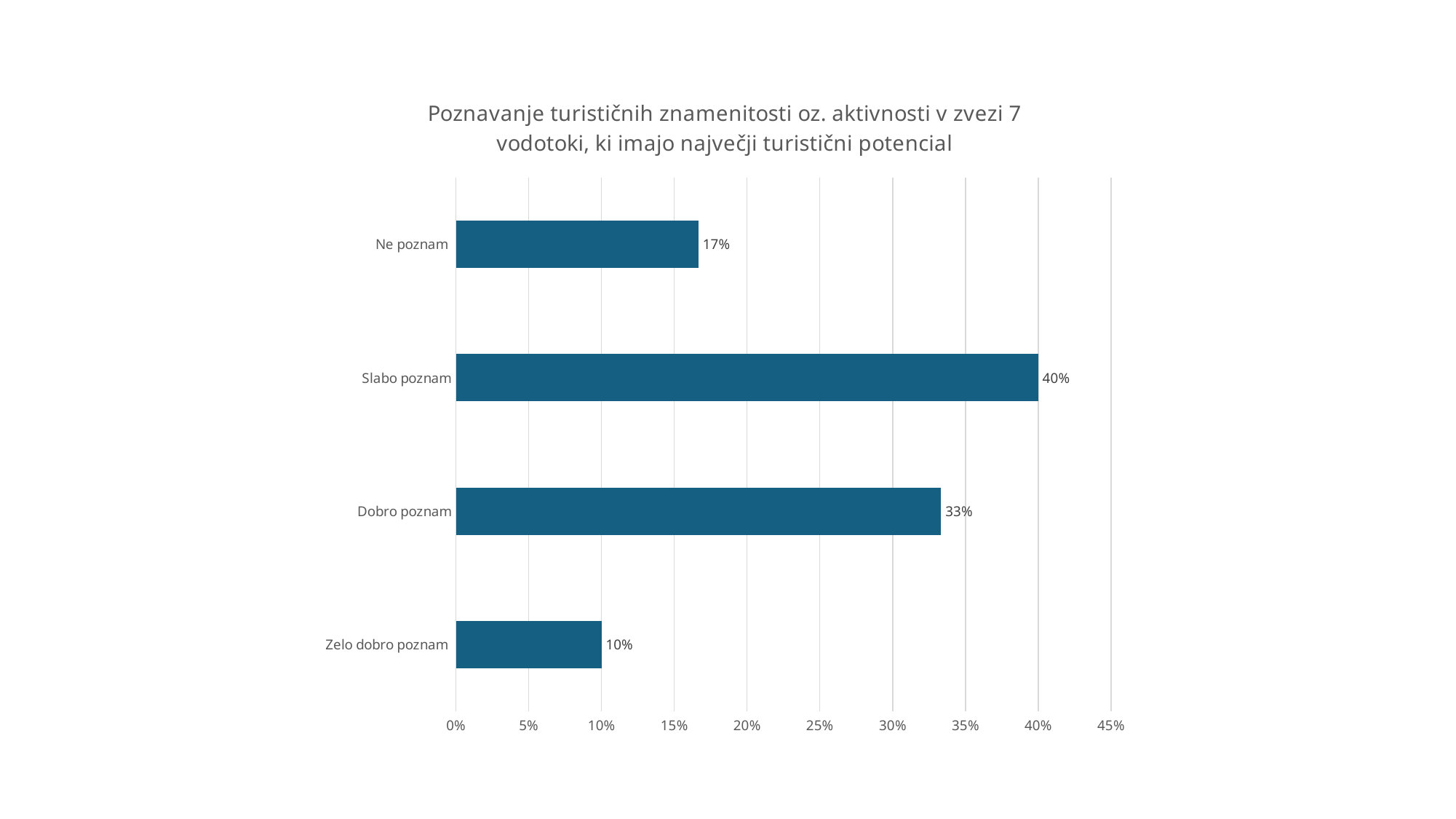
How many categories are shown in the chart? 4 What is the value for Dobro poznam? 33% Which category has the lowest value? Zelo dobro poznam What is the difference between the values for Slabo poznam and Dobro poznam? 7% What is the highest value shown on the horizontal axis? 45% Is the value for Dobro poznam greater or less than 30%? greater What kind of chart is shown on the slide? bar chart What is the value for Ne poznam? 17% Which is larger, the value for Ne poznam or the value for Zelo dobro poznam? Ne poznam What is the value for Slabo poznam? 40% Which category has the highest value? Slabo poznam What is the value for Zelo dobro poznam? 10%